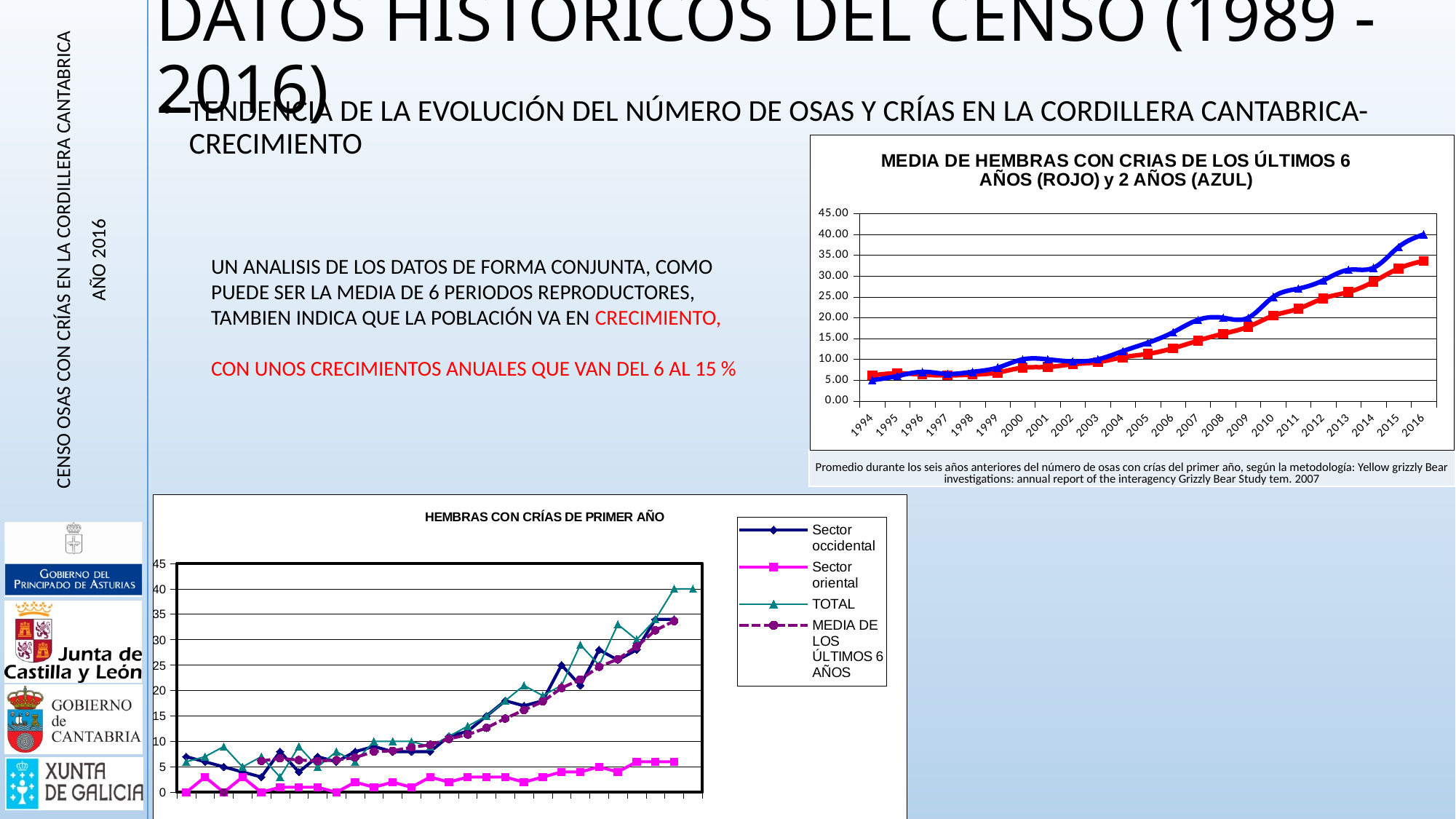
In the chart 'MEDIA DE HEMBRAS CON CRIAS DE LOS ÚLTIMOS 6 AÑOS', do the values generally rise or fall from 1994 to 2016? Rise In the chart 'MEDIA DE HEMBRAS CON CRIAS DE LOS ÚLTIMOS 6 AÑOS', which line has the larger value in 2016, the blue line or the red line? The blue line In the chart 'MEDIA DE HEMBRAS CON CRIAS DE LOS ÚLTIMOS 6 AÑOS', is the blue line's value for 2016 greater or less than 35.00? greater How many series does the legend of the chart 'HEMBRAS CON CRÍAS DE PRIMER AÑO' list? 4 In the chart 'HEMBRAS CON CRÍAS DE PRIMER AÑO', which series is shown in magenta with square markers? Sector oriental In the chart 'HEMBRAS CON CRÍAS DE PRIMER AÑO', which series has the highest value at the right end of the chart? TOTAL In the chart 'MEDIA DE HEMBRAS CON CRIAS DE LOS ÚLTIMOS 6 AÑOS', how many years are shown on the x axis? 23 In the chart 'MEDIA DE HEMBRAS CON CRIAS DE LOS ÚLTIMOS 6 AÑOS', what is the first year on the x axis? 1994 In the chart 'MEDIA DE HEMBRAS CON CRIAS DE LOS ÚLTIMOS 6 AÑOS', is the blue line's value for 1994 greater or less than 10.00? less What kind of chart is the chart titled 'MEDIA DE HEMBRAS CON CRIAS DE LOS ÚLTIMOS 6 AÑOS (ROJO) y 2 AÑOS (AZUL)'? Line chart In the chart 'MEDIA DE HEMBRAS CON CRIAS DE LOS ÚLTIMOS 6 AÑOS', is the red line's value for 2016 greater or less than 30.00? greater